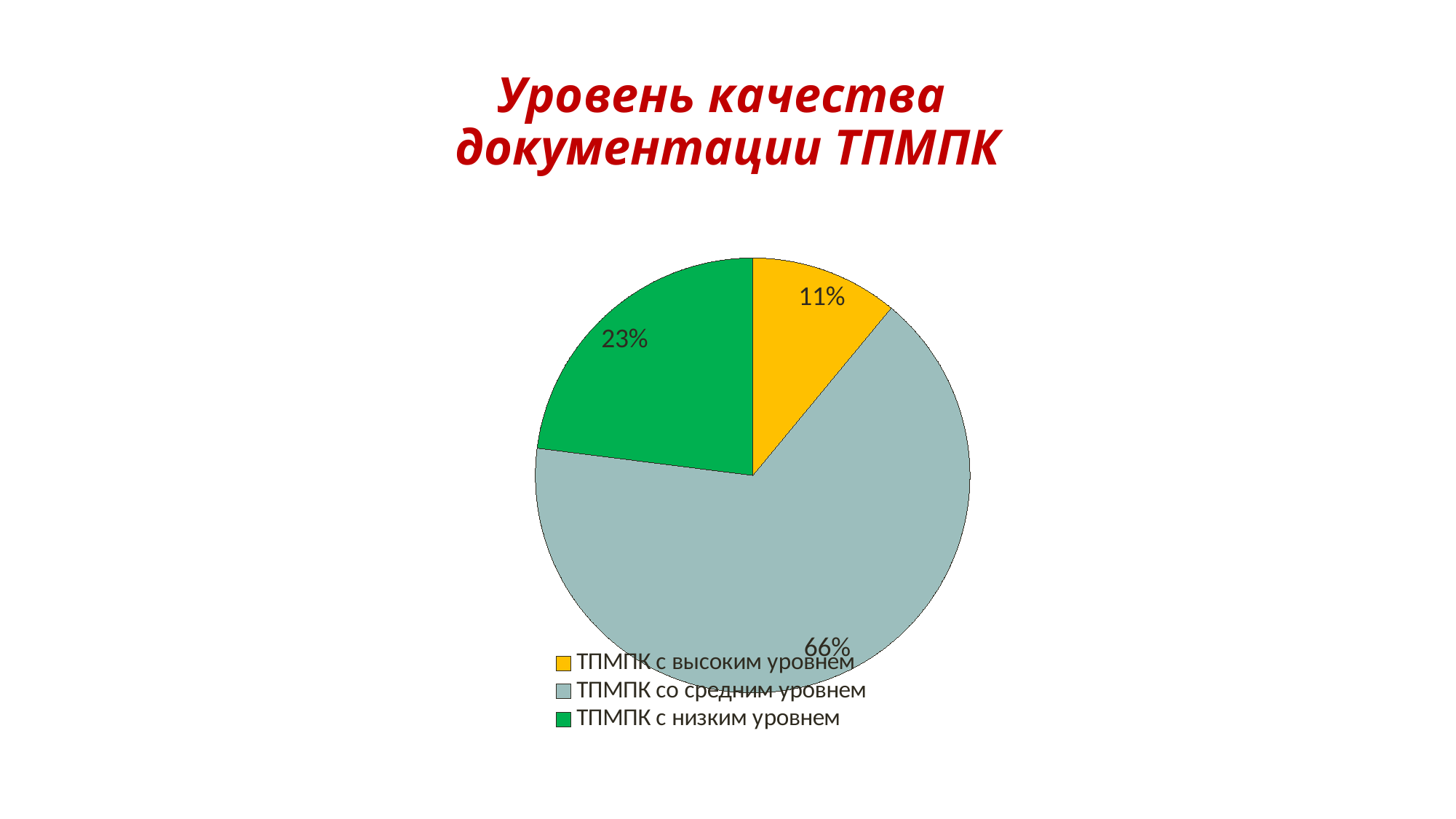
What share of the pie is labelled for ТПМПК со средним уровнем? 66% What is the title of the chart on the slide? Уровень качества документации ТПМПК What kind of chart is shown on the slide? pie chart Which category has the smallest slice of the pie? ТПМПК с высоким уровнем What is the difference in percentage points between ТПМПК со средним уровнем and ТПМПК с низким уровнем? 43 What share of the pie is labelled for ТПМПК с низким уровнем? 23% What share of the pie is labelled for ТПМПК с высоким уровнем? 11% What colour is the slice for ТПМПК с низким уровнем? green Which is larger: the slice for ТПМПК с низким уровнем or the slice for ТПМПК с высоким уровнем? ТПМПК с низким уровнем What is the difference in percentage points between ТПМПК с низким уровнем and ТПМПК с высоким уровнем? 12 How many slices does the pie chart have? 3 Which category has the largest slice of the pie? ТПМПК со средним уровнем